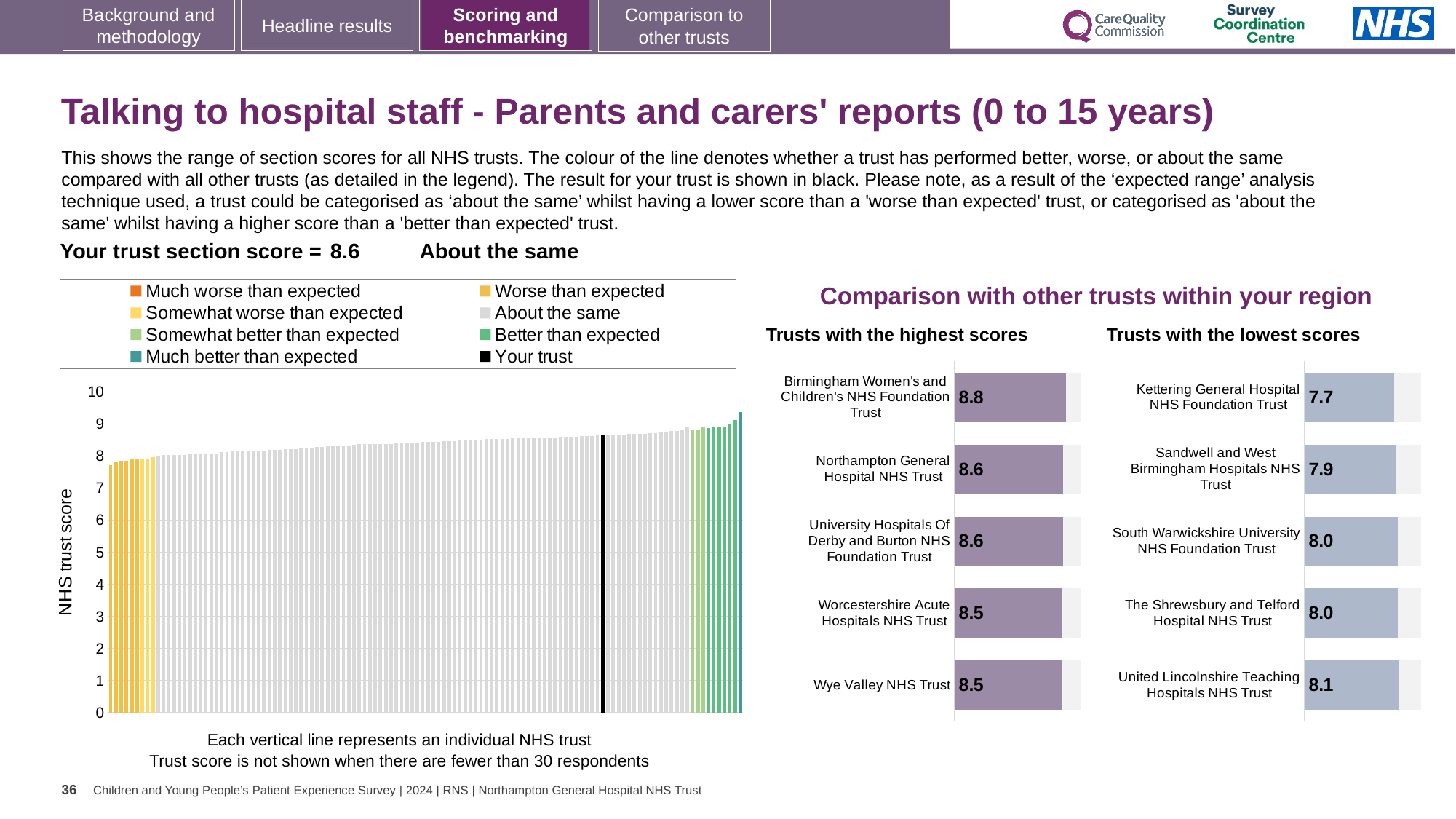
In the 'Trusts with the lowest scores' chart, what is the score for Kettering General Hospital NHS Foundation Trust? 7.7 In the 'Trusts with the highest scores' chart, which trust has the highest score? Birmingham Women's and Children's NHS Foundation Trust How many trusts are shown in the 'Trusts with the highest scores' chart? 5 In the 'Trusts with the highest scores' chart, which has the larger score: Birmingham Women's and Children's NHS Foundation Trust or Wye Valley NHS Trust? Birmingham Women's and Children's NHS Foundation Trust In the 'Trusts with the lowest scores' chart, which trust has the lowest score? Kettering General Hospital NHS Foundation Trust In the 'Trusts with the highest scores' chart, what is the score for Birmingham Women's and Children's NHS Foundation Trust? 8.8 In the 'Trusts with the lowest scores' chart, what is the difference between the scores of United Lincolnshire Teaching Hospitals NHS Trust and Kettering General Hospital NHS Foundation Trust? 0.4 In the main chart of all NHS trusts, is the value for the black 'Your trust' bar greater or less than 8? greater What kind of chart is the main chart showing the range of section scores for all NHS trusts? bar chart In the 'Trusts with the lowest scores' chart, what is the score for Sandwell and West Birmingham Hospitals NHS Trust? 7.9 How many entries does the legend of the main chart of all NHS trusts list? 8 In the main chart of all NHS trusts, do the trust scores rise or fall from left to right along the x axis? rise